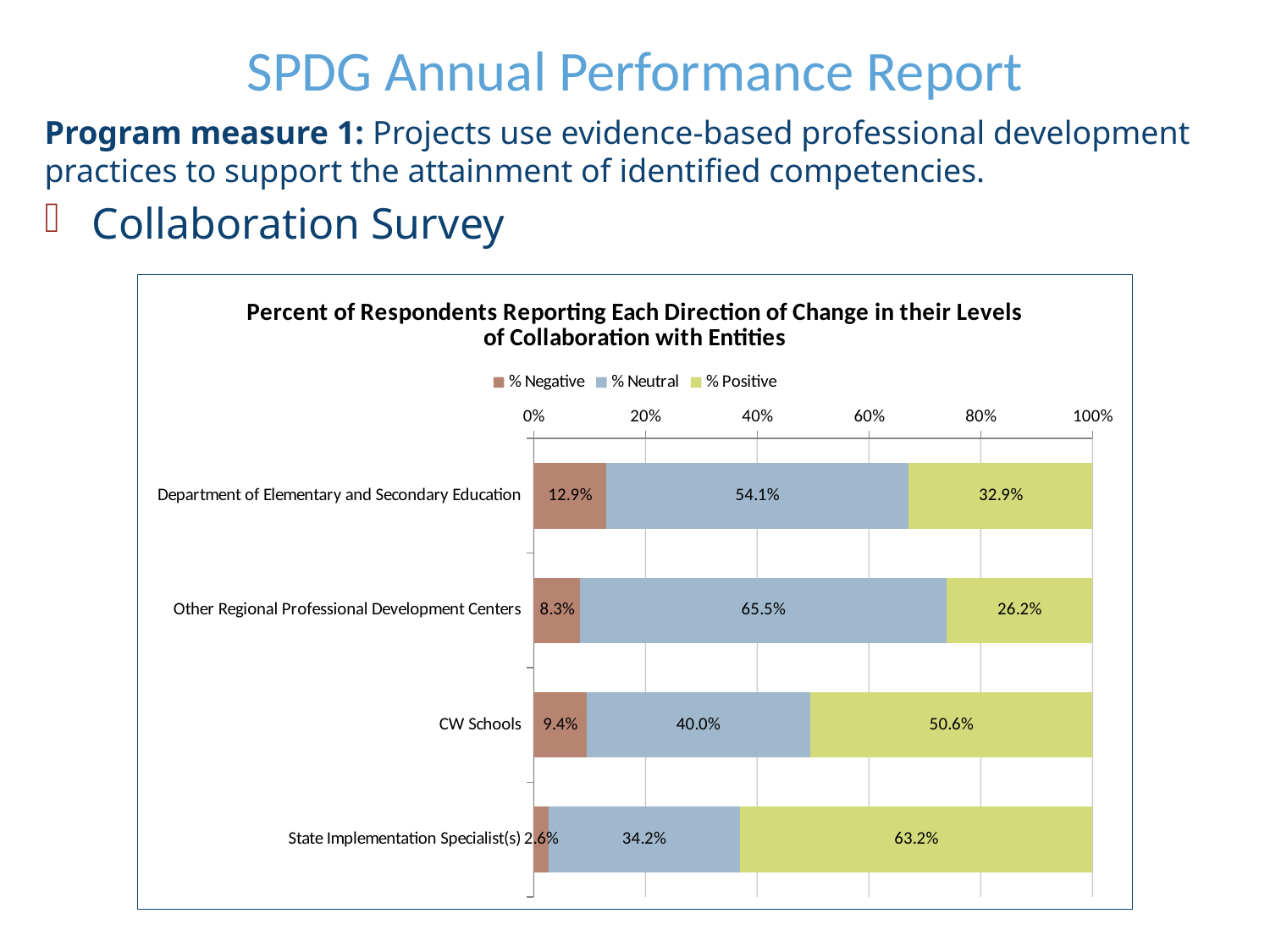
What is the total of the stacked bar for Other Regional Professional Development Centers? 100.0% Which entity has the highest % Positive value? State Implementation Specialist(s) What is the % Negative value for the Department of Elementary and Secondary Education? 12.9% What kind of chart is shown on the slide? Stacked bar chart What percentage of respondents reported a positive change in collaboration with CW Schools? 50.6% How many series does the legend list? 3 Which entity has the lowest % Negative value? State Implementation Specialist(s) Which series is shown in green in the chart? % Positive Is the % Neutral value larger for the Department of Elementary and Secondary Education or for CW Schools? Department of Elementary and Secondary Education What is the difference between the % Positive values for State Implementation Specialist(s) and CW Schools? 12.6% What is the % Neutral value for Other Regional Professional Development Centers? 65.5% How many entities (categories) are shown in the chart? 4